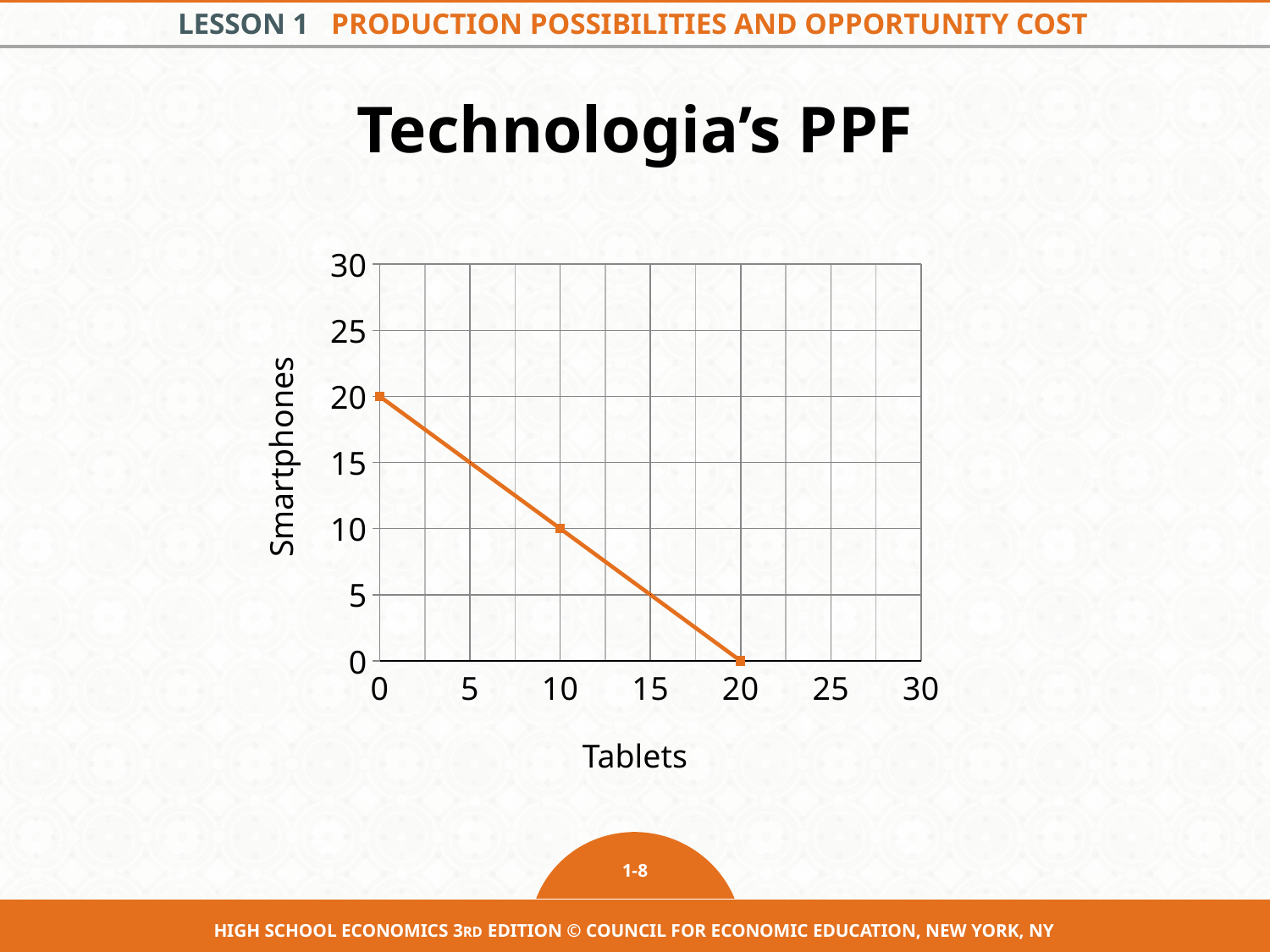
How many smartphones are produced when 20 tablets are produced? 0 At which number of tablets is the number of smartphones highest? 0 At which number of tablets is the number of smartphones lowest? 20 What type of chart is shown on the slide? line chart Do the smartphone values rise or fall as the number of tablets increases? fall What is the label of the horizontal axis? Tablets What is the difference in smartphones between producing 0 tablets and producing 10 tablets? 10 What is the title of the chart? Technologia's PPF Is the number of smartphones at 0 tablets greater or less than 15? greater How many smartphones are produced when 10 tablets are produced? 10 How many smartphones are produced when 0 tablets are produced? 20